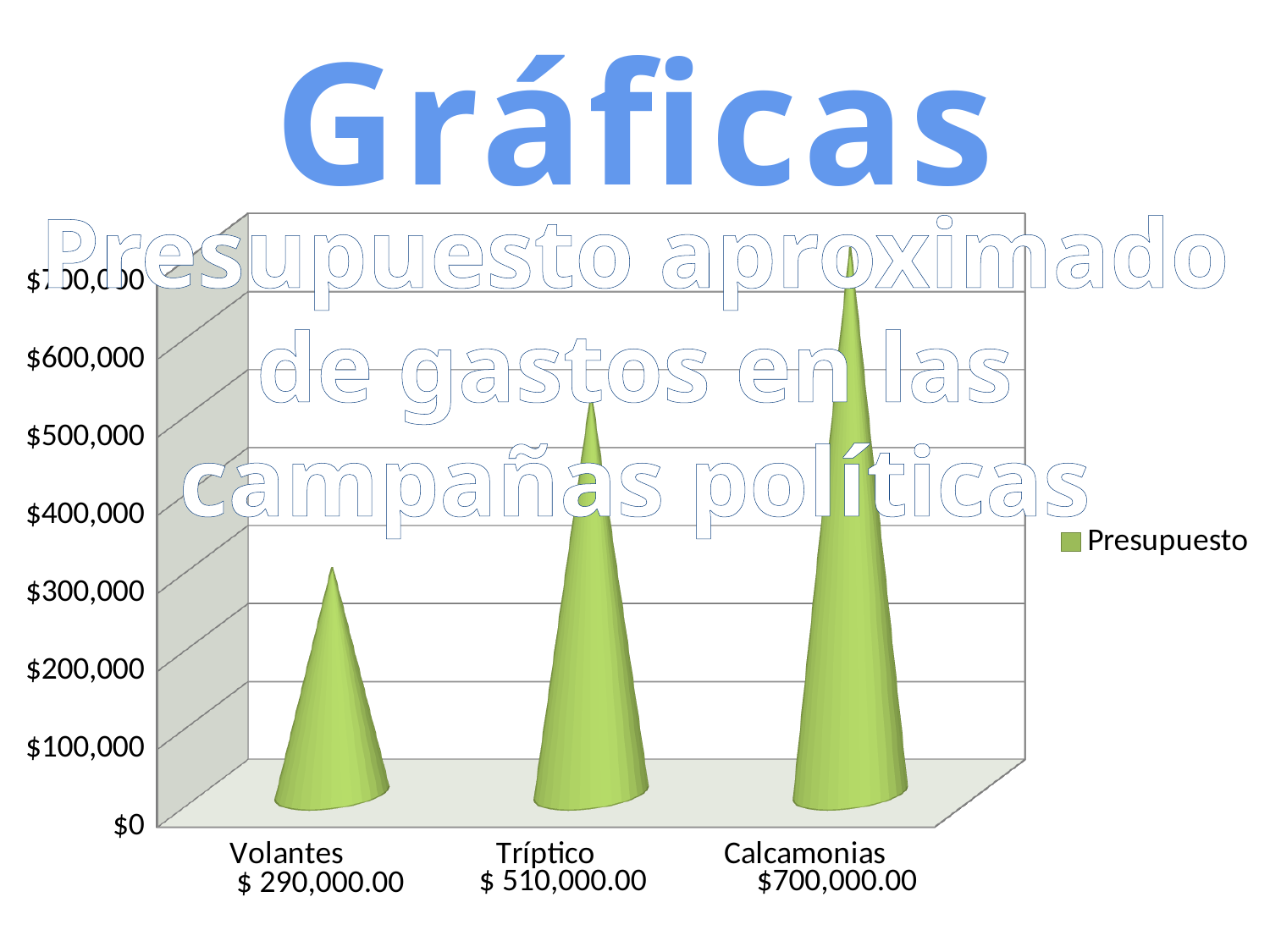
Is the value for Tríptico greater or less than $400,000? greater Which category has the lowest value? Volantes Do the values rise or fall from left to right along the x axis? rise What is the value for Calcamonias? $700,000.00 What is the value for Tríptico? $ 510,000.00 What is the difference between the values for Tríptico and Volantes? $220,000.00 How many series does the legend list? 1 Which category has the highest value? Calcamonias Which is larger, the value for Tríptico or the value for Volantes? Tríptico How many categories are shown on the x axis? 3 What is the difference between the values for Calcamonias and Volantes? $410,000.00 What is the value for Volantes? $ 290,000.00